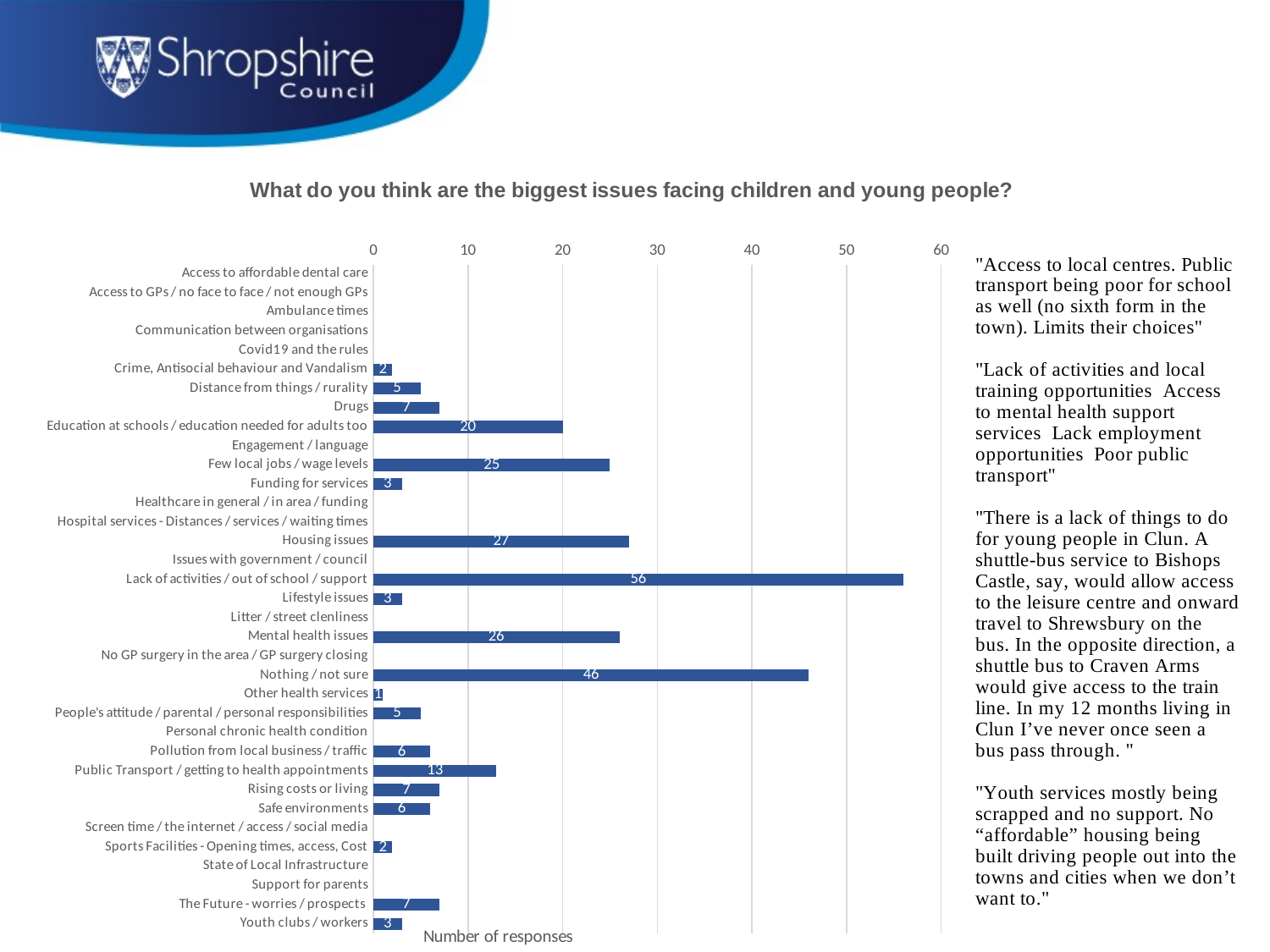
How many responses are shown for "Housing issues"? 27 How many responses are shown for "Public Transport / getting to health appointments"? 13 Is the value for "Nothing / not sure" greater or less than 40? greater What is the label on the horizontal axis of the chart? Number of responses How many responses are shown for "Nothing / not sure"? 46 What is the difference in responses between "Lack of activities / out of school / support" and "Nothing / not sure"? 10 Which has more responses, "Few local jobs / wage levels" or "Education at schools / education needed for adults too"? Few local jobs / wage levels Which category has the highest number of responses? Lack of activities / out of school / support What is the title of the chart? What do you think are the biggest issues facing children and young people? How many responses are shown for "Lack of activities / out of school / support"? 56 What type of chart is shown on the slide? bar chart What is the difference in responses between "Housing issues" and "Mental health issues"? 1